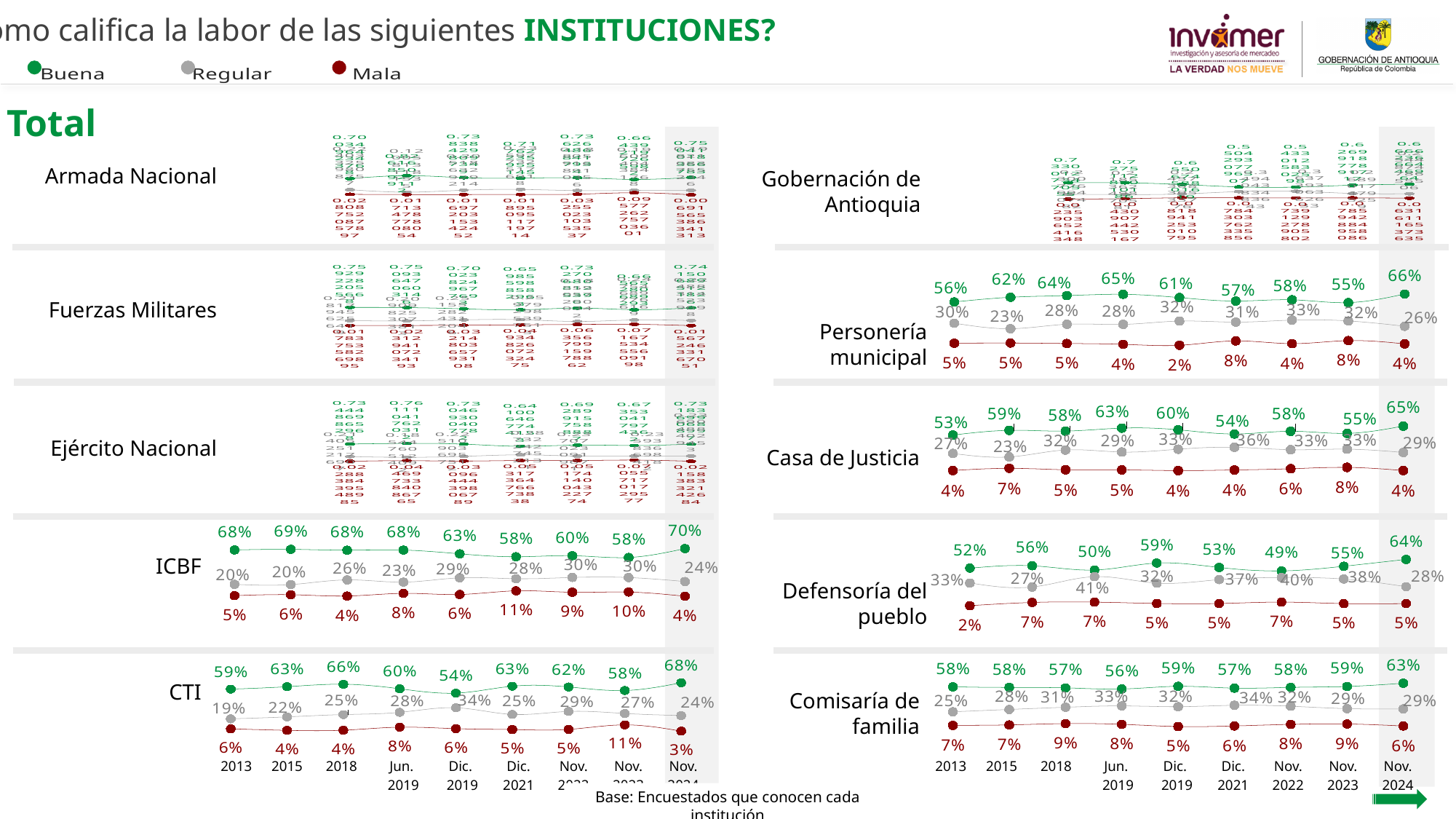
In the Casa de Justicia chart, what is the 'Mala' value for Nov. 2023? 8% In the CTI chart, what is the 'Mala' value for Nov. 2023? 11% What kind of chart is used for the ICBF data? Line chart How many time periods are plotted along the x axis of the ICBF chart? 9 In the Personería municipal chart, in which period is the 'Mala' value lowest? Dic. 2019 In the Personería municipal chart, in which period is the 'Buena' value highest? Nov. 2024 In the Comisaría de familia chart, what is the 'Regular' value for 2013? 25% How many series does the legend at the top of the slide list? 3 In the ICBF chart, in which period is the 'Mala' value highest? Dic. 2021 In the CTI chart, which is larger: the 'Buena' value for Dic. 2019 or for Nov. 2024? Nov. 2024 In the ICBF chart, what percentage rated the institution 'Buena' in Nov. 2024? 70% In the Comisaría de familia chart, by how many percentage points does the 'Buena' value in Nov. 2024 exceed the 'Buena' value in 2013? 5 percentage points